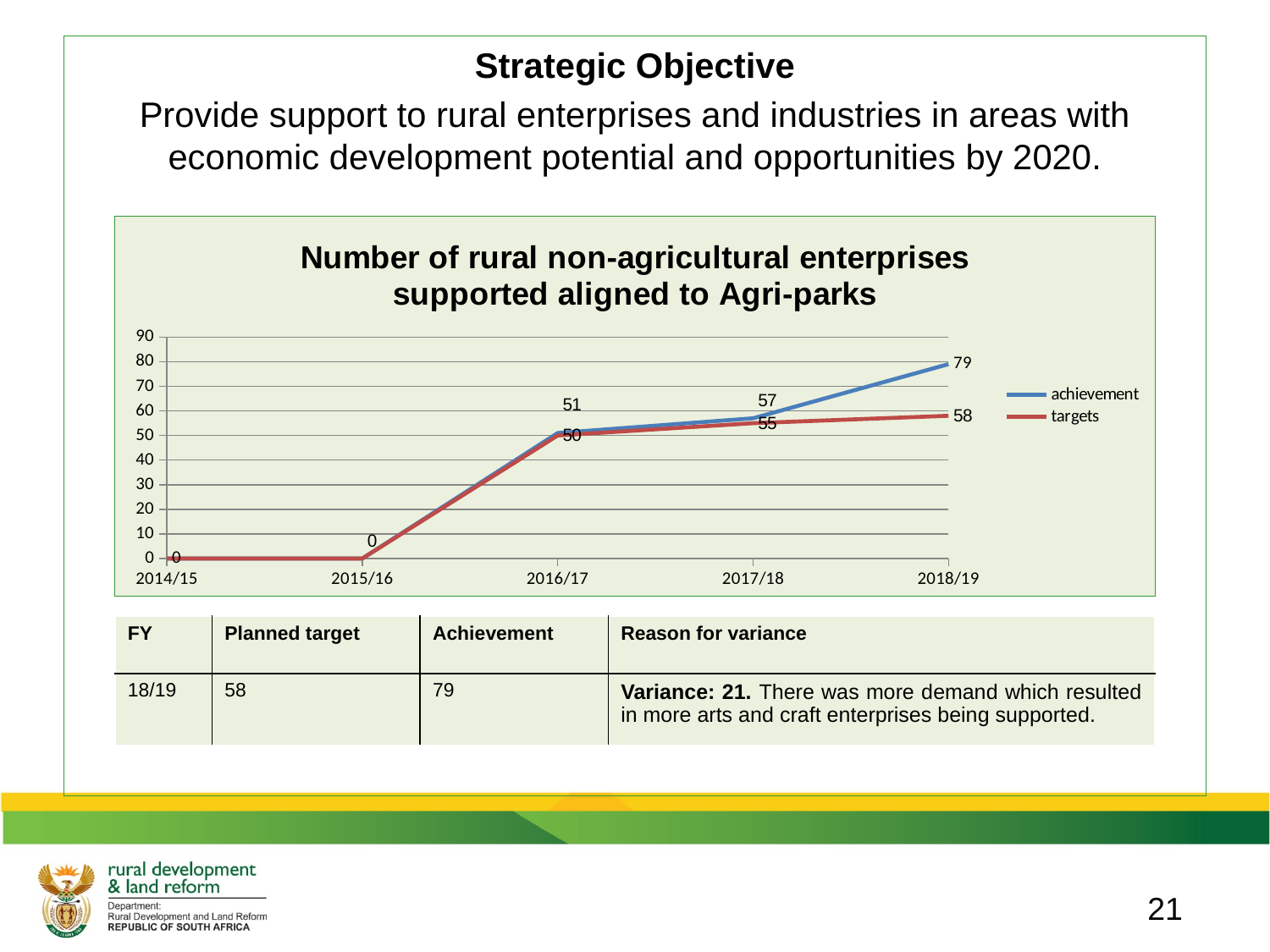
Which is larger in 2017/18, achievement or targets? achievement What is the achievement value for 2016/17? 51 What is the difference between achievement and targets in 2018/19? 21 In which year is the achievement value highest? 2018/19 What is the targets value for 2017/18? 55 What is the targets value for 2018/19? 58 How many series does the legend list? 2 Is the achievement value for 2018/19 greater or less than 70? greater What is the achievement value for 2018/19? 79 How many financial years are shown on the x axis? 5 Does the achievement line rise or fall from 2016/17 to 2018/19? rise What type of chart is shown on the slide? line chart